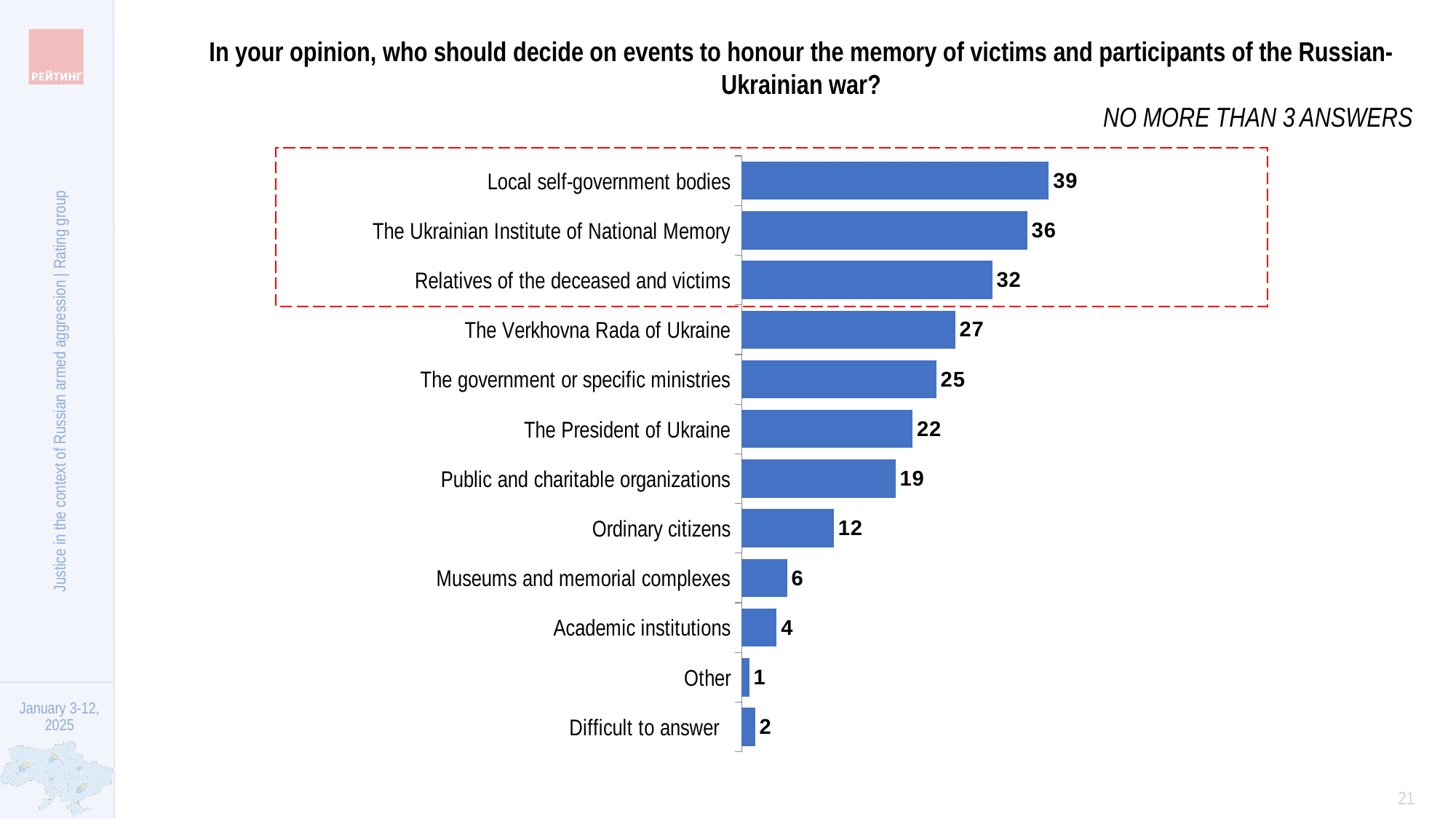
How many categories are enclosed by the red dashed box? 3 Which category has the lowest value? Other What is the difference between the values for The President of Ukraine and Ordinary citizens? 10 What kind of chart is shown on the slide? Bar chart Which is larger, the value for Academic institutions or the value for Difficult to answer? Academic institutions What is the value for The Verkhovna Rada of Ukraine? 27 Which is larger, the value for The government or specific ministries or the value for Public and charitable organizations? The government or specific ministries What is the difference between the values for Local self-government bodies and Relatives of the deceased and victims? 7 What is the value for Local self-government bodies? 39 Which category has the highest value? Local self-government bodies How many categories are shown in the chart? 12 What is the value for Museums and memorial complexes? 6